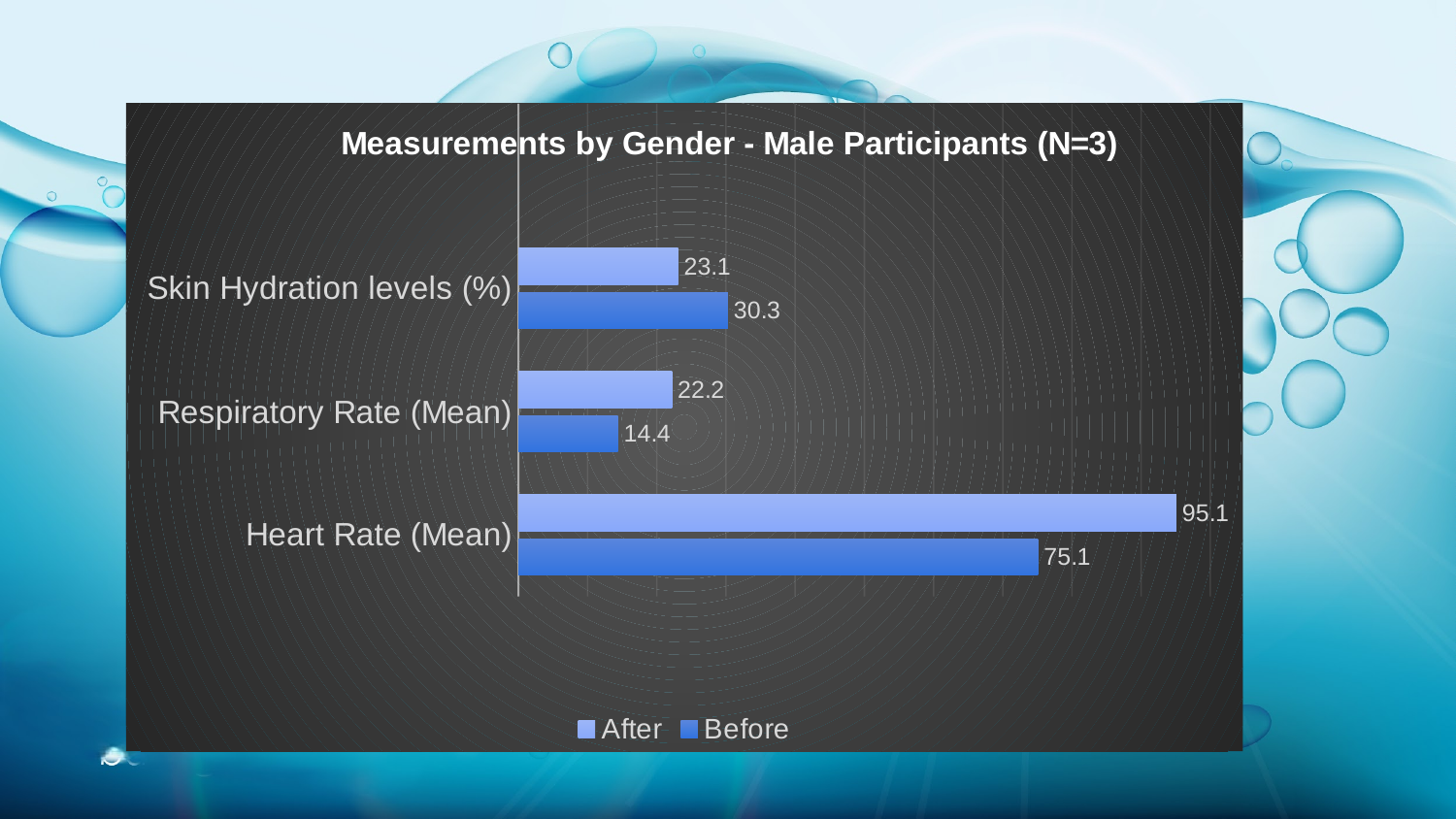
Which category has the lowest After value? Respiratory Rate (Mean) What is the title of the chart? Measurements by Gender - Male Participants (N=3) Which category has the highest Before value? Heart Rate (Mean) What is the After value for Respiratory Rate (Mean)? 22.2 What kind of chart is shown on the slide? Bar chart How many series does the legend list? 2 For Skin Hydration levels (%), which is larger, the After value or the Before value? Before How many categories are shown on the chart? 3 What is the After value for Heart Rate (Mean)? 95.1 What is the Before value for Skin Hydration levels (%)? 30.3 What is the Before value for Respiratory Rate (Mean)? 14.4 What is the difference between the After and Before values for Heart Rate (Mean)? 20.0